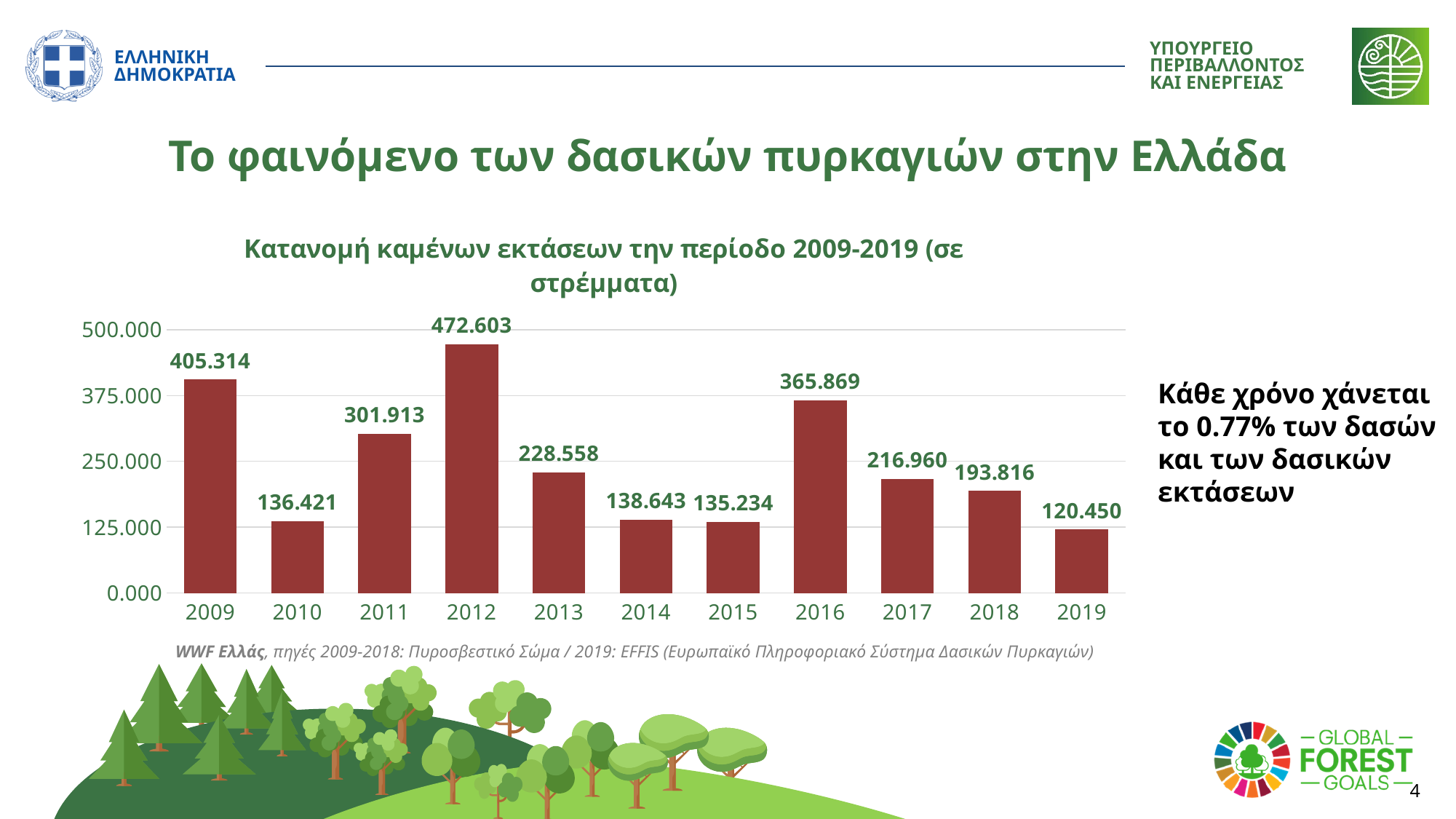
Which is larger, the value for 2011 or the value for 2013? 2011 Do the values rise or fall from 2016 to 2019? fall Which year has the lowest value? 2019 How many years are shown on the x axis? 11 What is the difference between the values for 2012 and 2009? 67.289 What is the difference between the values for 2016 and 2017? 148.909 What is the value for 2019? 120.450 Is the value for 2013 greater or less than 250.000? less What is the value for 2012? 472.603 What kind of chart is shown on the slide? bar chart What is the value for 2016? 365.869 Which year has the highest value? 2012